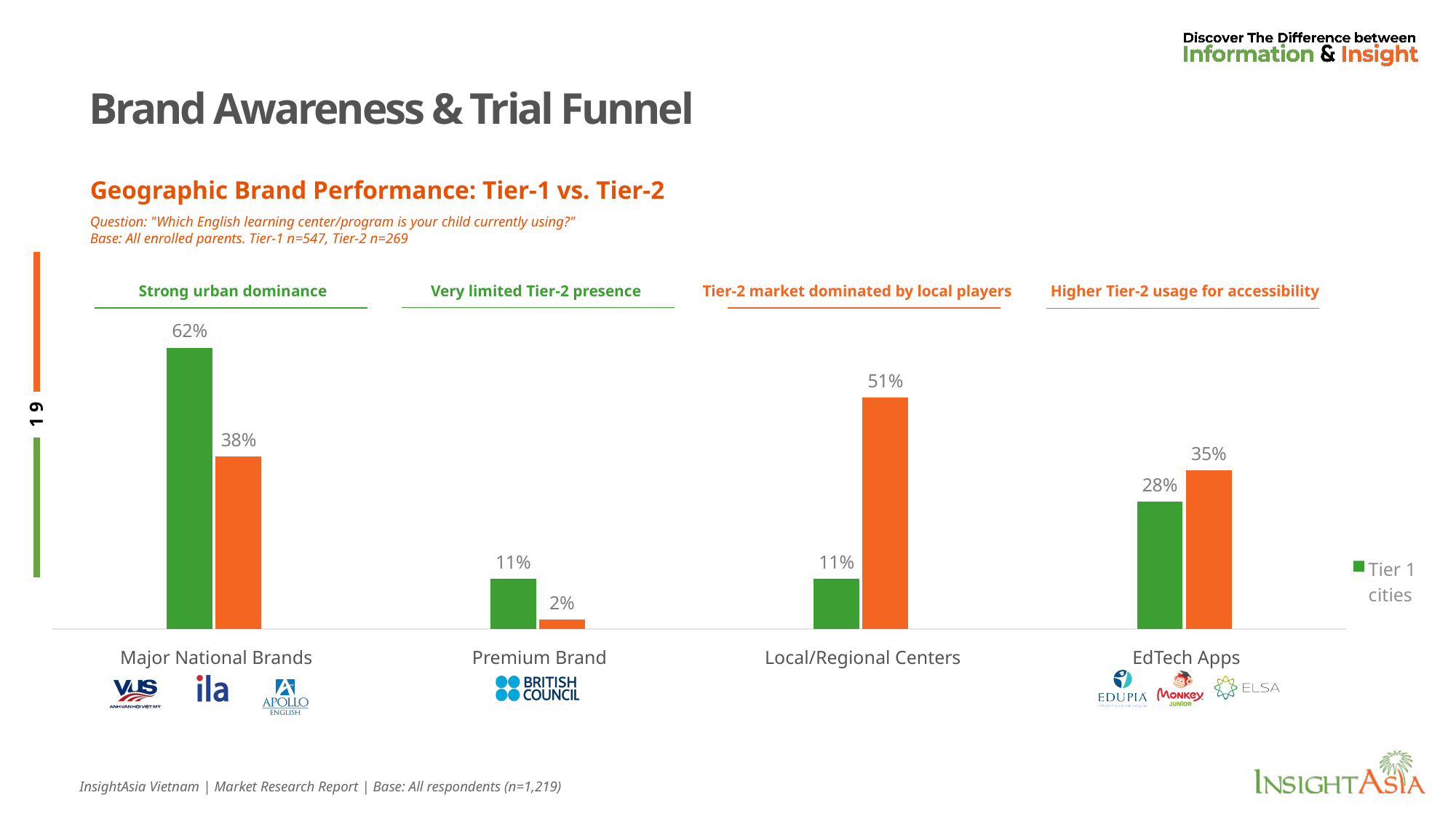
What is the value of the Tier 1 cities bar for EdTech Apps? 28% What type of chart is shown on the slide? Bar chart Which category has the highest Tier 1 cities value? Major National Brands Which category has the lowest orange (Tier-2) bar value? Premium Brand What is the value of the orange (Tier-2) bar for Local/Regional Centers? 51% What colour are the Tier 1 cities bars in the chart? Green For Major National Brands, what is the difference between the Tier 1 cities bar and the orange (Tier-2) bar? 24% What is the value of the orange (Tier-2) bar for Premium Brand? 2% How many categories are shown on the x axis of the chart? 4 For EdTech Apps, which bar is larger: the Tier 1 cities bar or the orange (Tier-2) bar? The orange (Tier-2) bar For Local/Regional Centers, how much higher is the orange (Tier-2) bar than the Tier 1 cities bar? 40% What is the value of the Tier 1 cities bar for Major National Brands? 62%